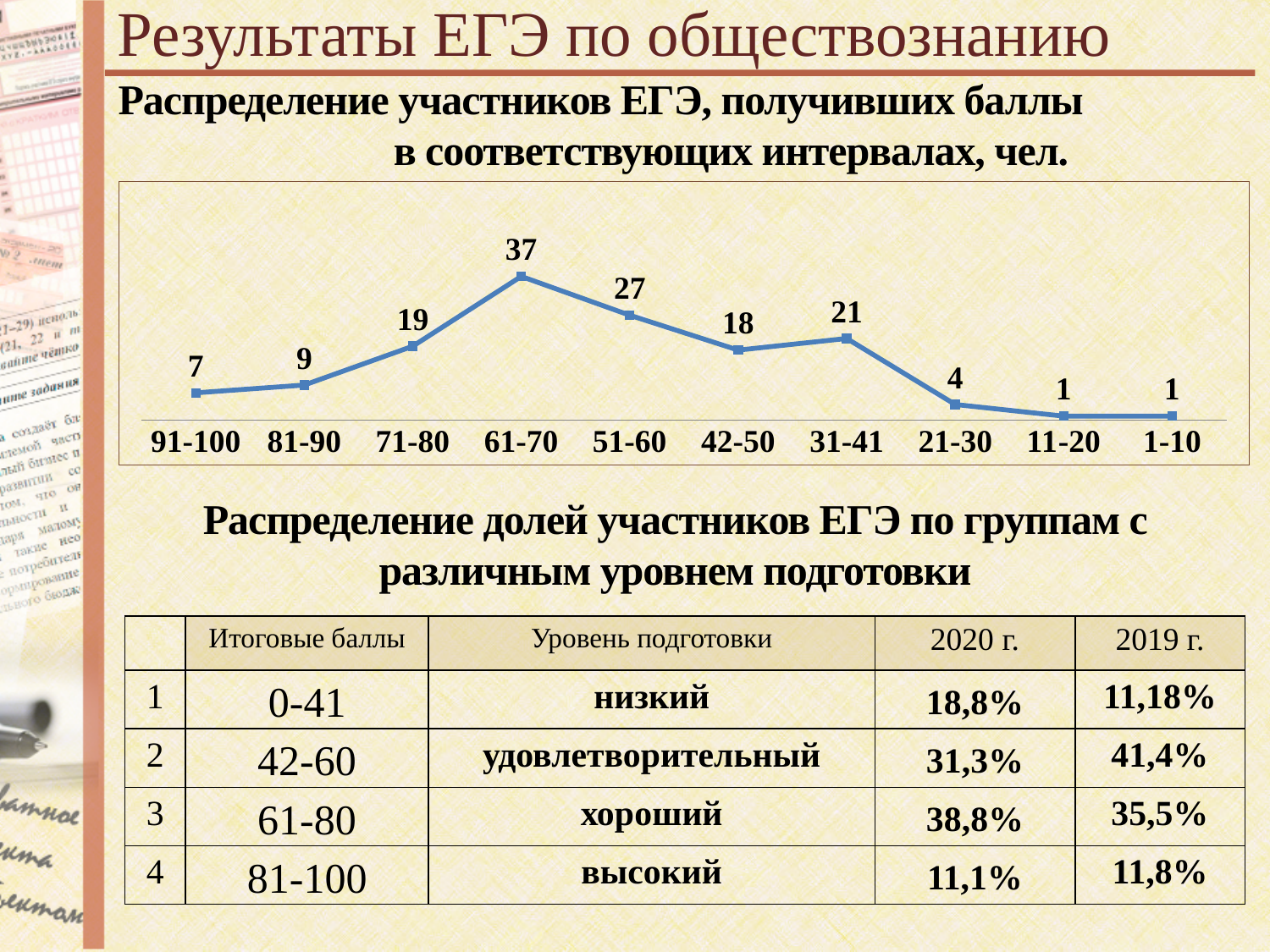
What is the value for the 21-30 interval? 4 What is the value for the 31-41 interval? 21 What is the difference between the values for 61-70 and 51-60? 10 Which score interval has the highest number of participants? 61-70 What is the value for the 91-100 interval? 7 Which is larger, the value for 42-50 or the value for 31-41? 31-41 What is the difference between the values for 71-80 and 81-90? 10 How many score intervals are plotted on the x axis of the chart? 10 What type of chart is shown on the slide? line chart Which score intervals have the lowest number of participants? 11-20 and 1-10 What is the value for the 61-70 interval? 37